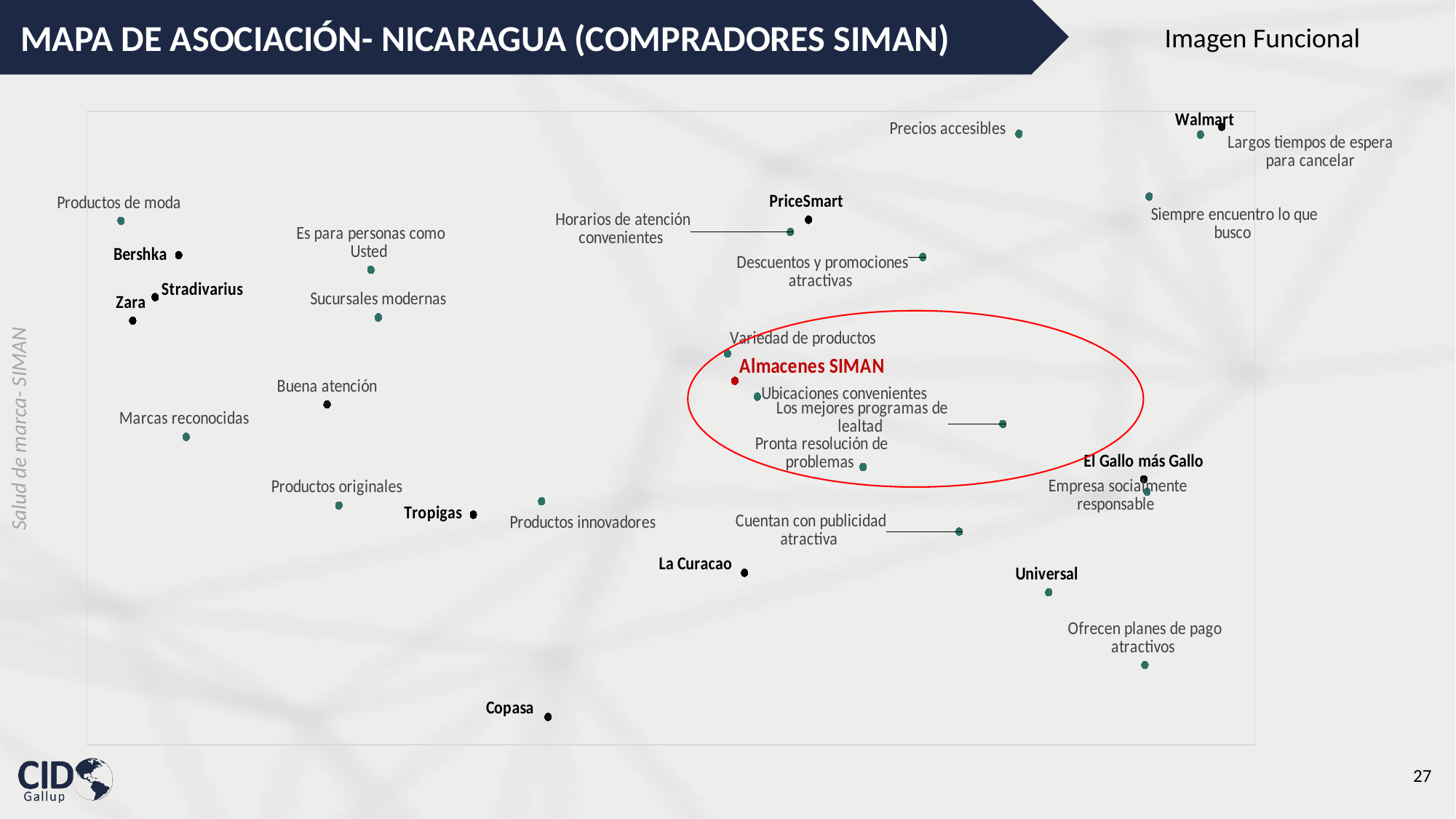
Which attribute is plotted closest to Tropigas? Productos innovadores Which attributes are enclosed in the red ellipse together with Almacenes SIMAN? Variedad de productos, Ubicaciones convenientes, Los mejores programas de lealtad, Pronta resolución de problemas Which brand is plotted lowest on the map? Copasa Which brand is highlighted in red on the association map? Almacenes SIMAN Which brand is plotted highest on the map? Walmart Which attribute is plotted closest to PriceSmart? Horarios de atención convenientes Which attribute is plotted closest to El Gallo más Gallo? Empresa socialmente responsable How many brands (black or red points) are plotted on the map? 11 Which attribute is plotted lowest on the map? Ofrecen planes de pago atractivos Which attribute is plotted closest to Walmart? Largos tiempos de espera para cancelar What kind of chart is shown on the slide? Scatter plot (association map) Which brand is plotted furthest to the left on the map? Zara